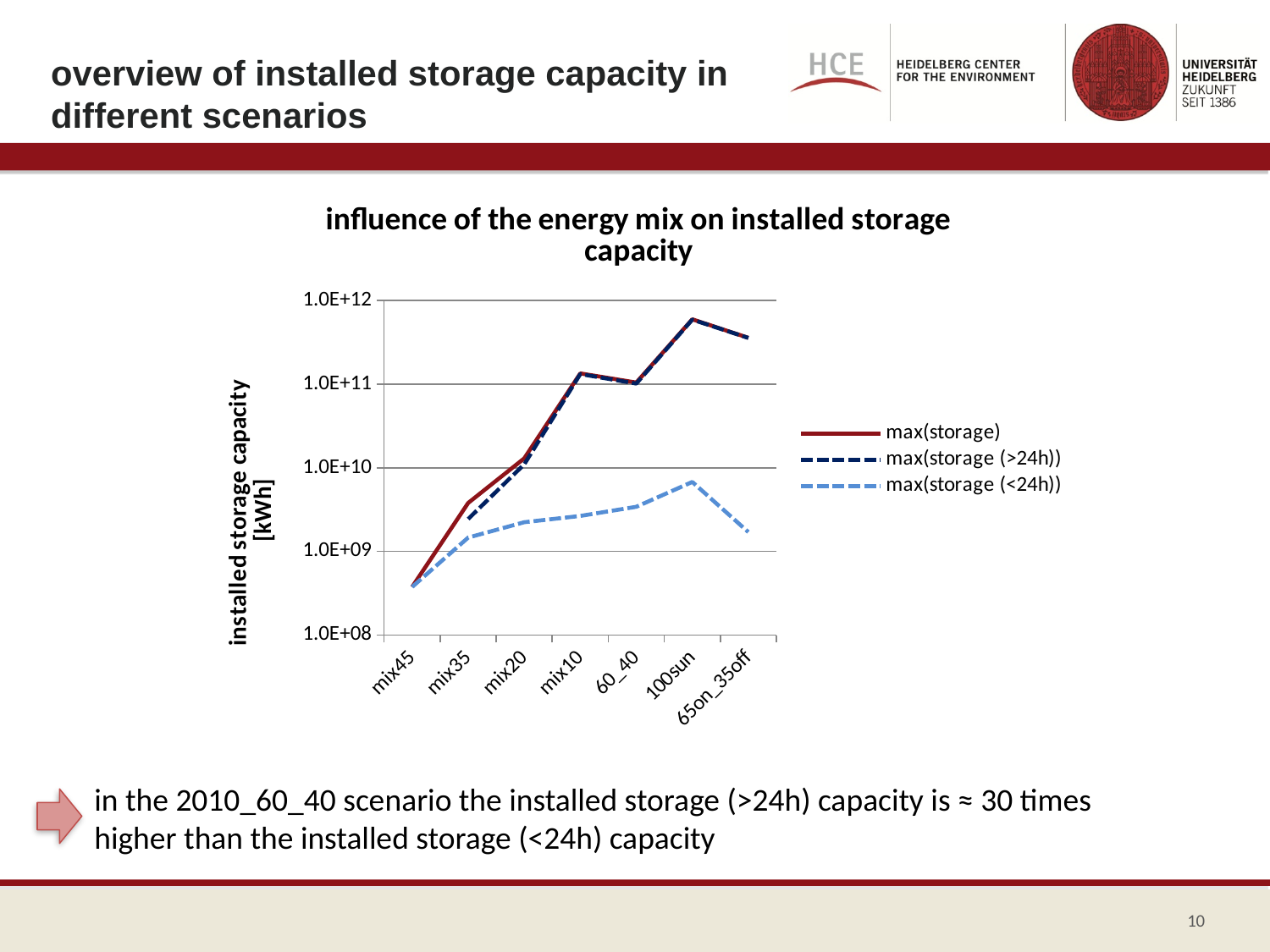
What is the label of the y axis of the chart? installed storage capacity [kWh] For which scenario is the max(storage (<24h)) series highest? 100sun What is the title of the chart? influence of the energy mix on installed storage capacity For which scenario is the max(storage) series highest? 100sun Does the max(storage) series rise or fall from mix45 to mix10? rise What kind of chart is shown on the slide? line chart How many series does the chart legend list? 3 Is the max(storage) value for 100sun greater or less than 1.0E+11? greater For which scenario is the max(storage) series lowest? mix45 Which scenario has the larger max(storage (<24h)) value, 100sun or 65on_35off? 100sun How many scenarios are plotted along the x axis of the chart? 7 Is the max(storage (<24h)) value for 100sun greater or less than 1.0E+10? less